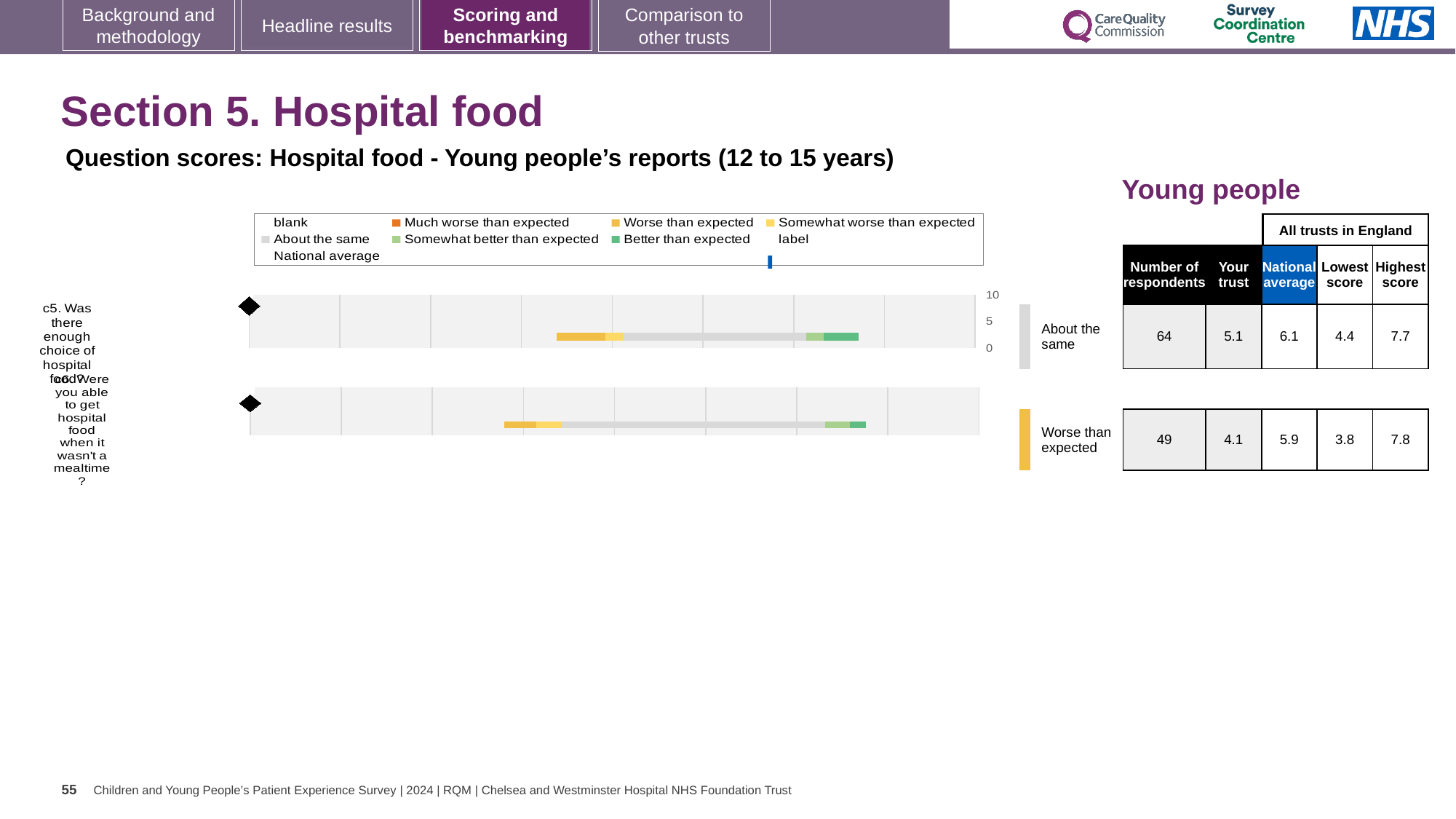
What is the highest value shown on the chart's numeric axis? 10 In the table, what is the difference between the national average and the 'Your trust' score for the row rated 'Worse than expected'? 1.8 Which legend entry is shown with a dark green colour? Better than expected In the table, what is the national average for the row rated 'About the same'? 6.1 What kind of chart is used to show the question scores for hospital food? bar chart In the table, which row has more respondents: 'About the same' or 'Worse than expected'? About the same In the table, what is the difference between the highest and lowest scores for the row rated 'About the same'? 3.3 How many survey questions are plotted in the hospital food chart? 2 In the table, how many respondents are listed for the row rated 'About the same'? 64 In the table, what is the lowest score across all trusts in England for the row rated 'Worse than expected'? 3.8 In the table, what is the highest score across all trusts in England for the row rated 'About the same'? 7.7 In the table, what is the 'Your trust' score for the row rated 'Worse than expected'? 4.1